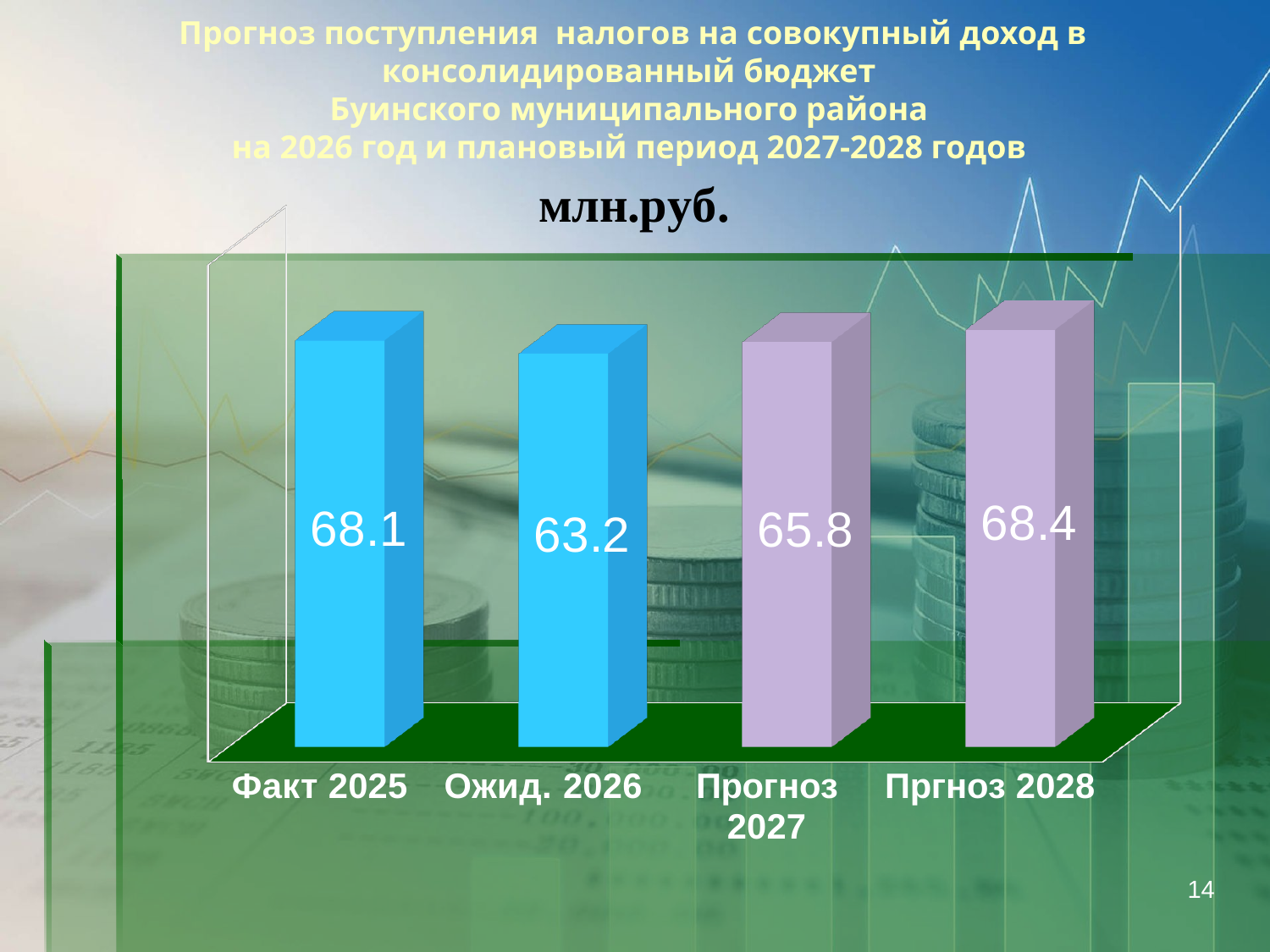
What is the value for Пргноз 2028? 68.4 Which is larger, the value for Прогноз 2027 or the value for Ожид. 2026? Прогноз 2027 What type of chart is shown on the slide? bar chart Do the values rise or fall from Ожид. 2026 to Пргноз 2028? rise What is the value for Факт 2025? 68.1 What is the difference between the values for Факт 2025 and Ожид. 2026? 4.9 Which category has the highest value? Пргноз 2028 Which category has the lowest value? Ожид. 2026 How many categories are plotted in the chart? 4 What is the value for Ожид. 2026? 63.2 What is the value for Прогноз 2027? 65.8 In what units are the chart values given? млн.руб.